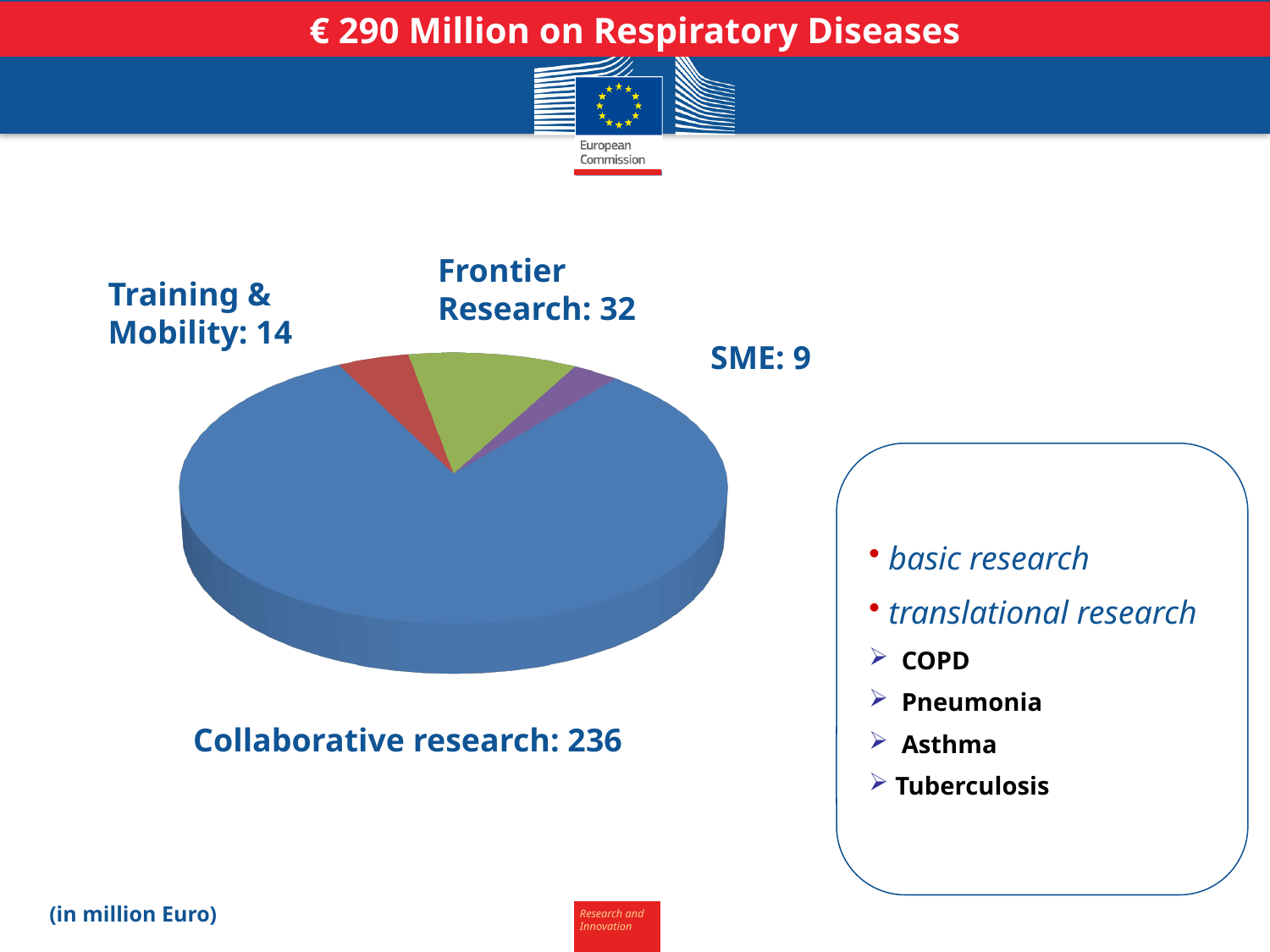
What is the difference between the values for Training & Mobility and SME? 5 What colour is the Collaborative research slice of the pie chart? Blue What is the value for Frontier Research in the pie chart? 32 What is the value for Collaborative research in the pie chart? 236 What is the value for SME in the pie chart? 9 What is the value for Training & Mobility in the pie chart? 14 Which category has the largest slice of the pie chart? Collaborative research Which is larger, Frontier Research or Training & Mobility? Frontier Research What kind of chart is shown on the slide? Pie chart Which category has the smallest slice of the pie chart? SME What is the difference between the values for Collaborative research and Frontier Research? 204 How many categories are shown in the pie chart? 4